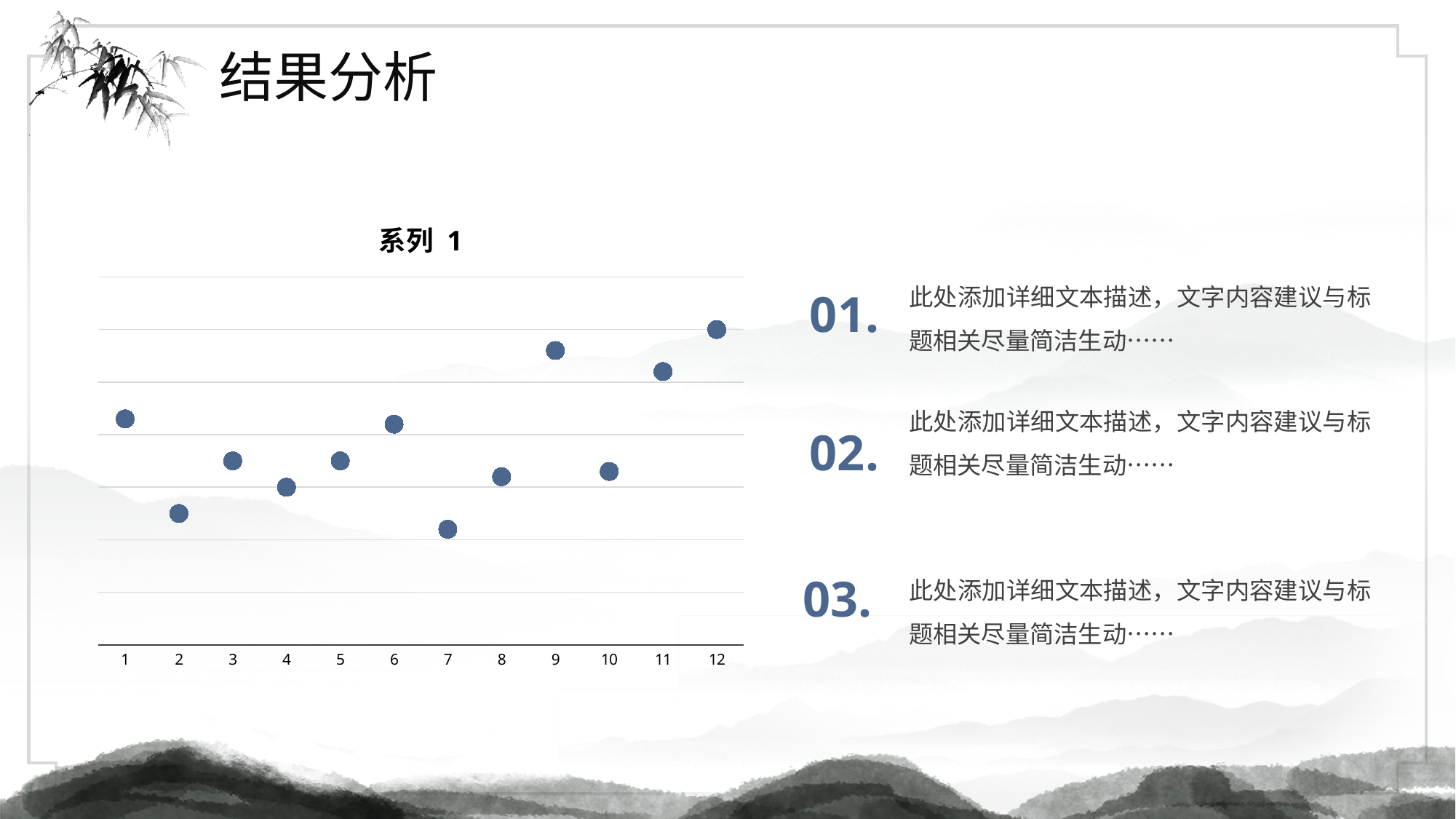
Which has the larger value, category 12 or category 1? 12 Which x-axis category has the lowest value? 7 From category 1 to category 2, do the values rise or fall? fall From category 7 to category 9, do the values rise or fall? rise What is the title of the chart? 系列 1 How many data points are plotted in the chart? 12 Which has the larger value, category 9 or category 11? 9 Which has the larger value, category 1 or category 2? 1 What kind of chart is shown on the slide? scatter chart Which x-axis category has the highest value? 12 What colour are the data points in the chart? blue